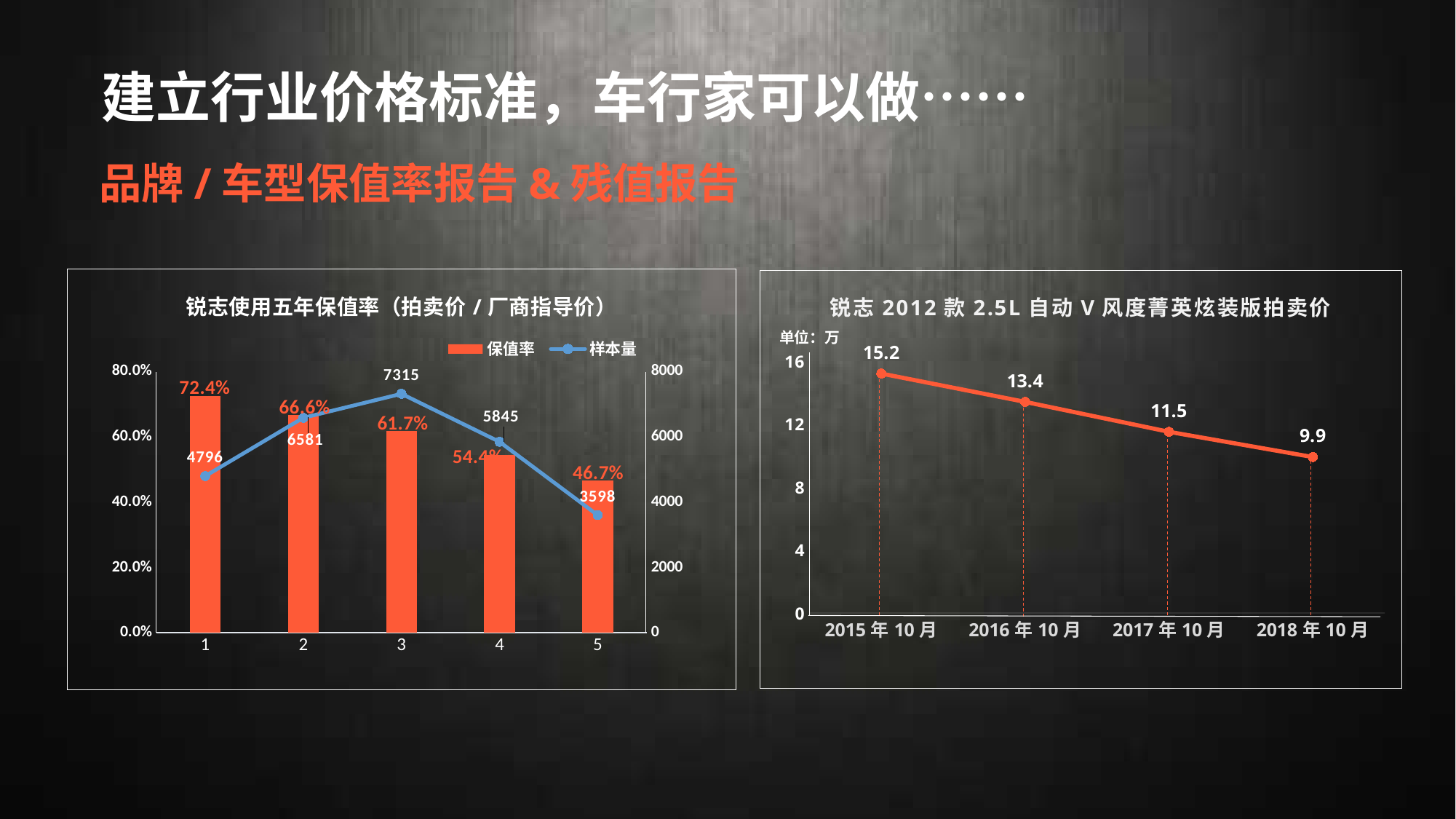
In the right chart (锐志 2012 款 2.5L 自动 V 风度菁英炫装版拍卖价), what is the difference between the values for 2015 年 10 月 and 2018 年 10 月? 5.3 In the left chart (锐志使用五年保值率), which year has the lowest 保值率? 5 In the left chart (锐志使用五年保值率), what is the difference between the 样本量 for year 2 and year 5? 2983 In the left chart (锐志使用五年保值率), what is the 保值率 value for year 1? 72.4% In the left chart (锐志使用五年保值率), what is the 样本量 value for year 3? 7315 In the left chart (锐志使用五年保值率), does the 保值率 rise or fall from year 1 to year 5? fall In the right chart (锐志 2012 款 2.5L 自动 V 风度菁英炫装版拍卖价), how many data points are plotted? 4 What kind of chart is the right chart (锐志 2012 款 2.5L 自动 V 风度菁英炫装版拍卖价)? line chart In the left chart (锐志使用五年保值率), how many series does the legend list? 2 In the right chart (锐志 2012 款 2.5L 自动 V 风度菁英炫装版拍卖价), what unit is stated above the y axis? 万 In the right chart (锐志 2012 款 2.5L 自动 V 风度菁英炫装版拍卖价), what is the value for 2016 年 10 月? 13.4 In the left chart (锐志使用五年保值率), which year has the highest 样本量? 3